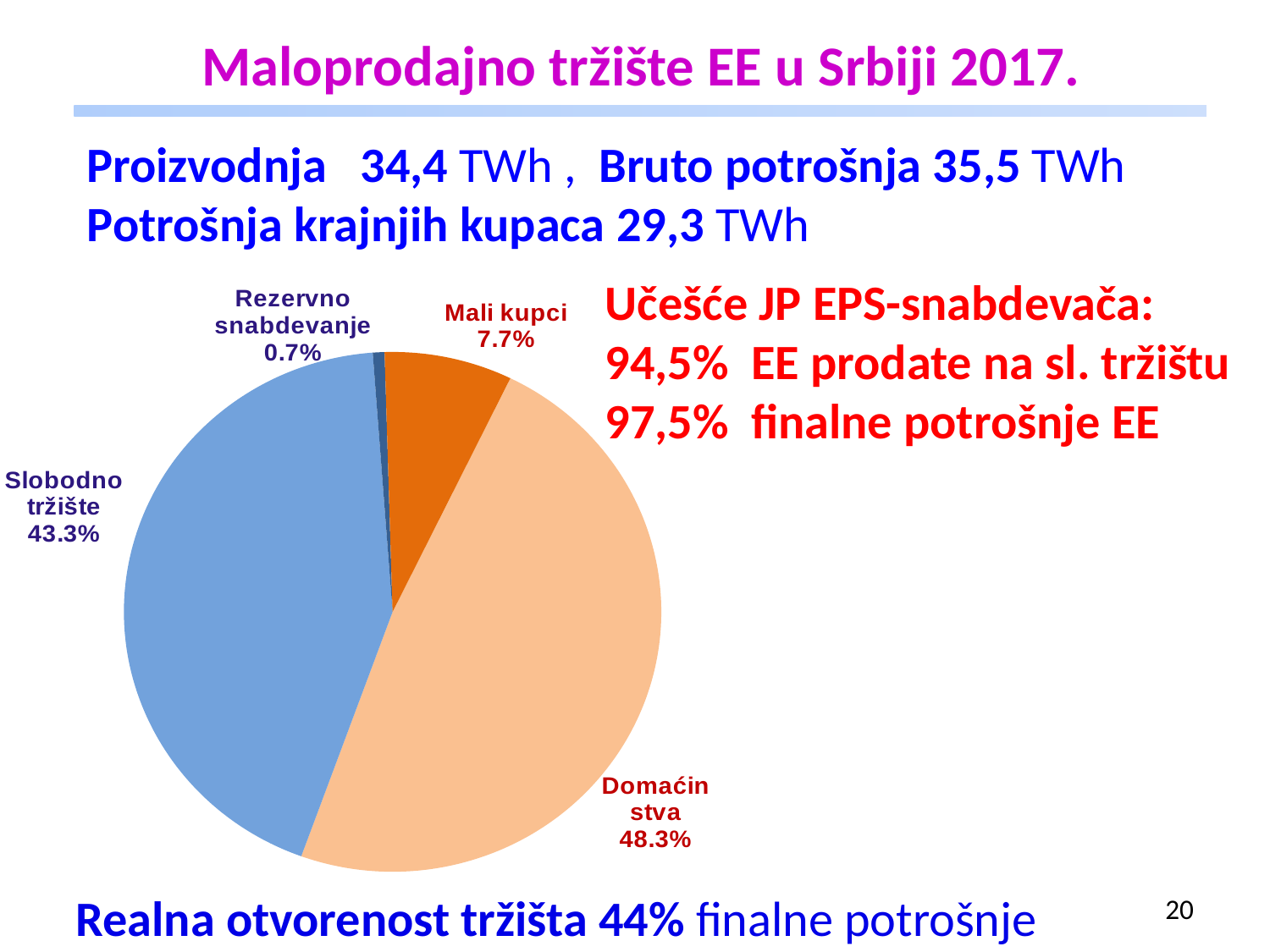
What is the value shown for Rezervno snabdevanje? 0.7% Which slice of the pie chart is the largest? Domaćinstva What share of the pie does Domaćinstva have? 48.3% What type of chart is shown on the slide? pie chart What is the difference between the shares of Mali kupci and Rezervno snabdevanje? 7.0% Which slice of the pie chart is the smallest? Rezervno snabdevanje What is the value shown for Mali kupci? 7.7% How many slices does the pie chart have? 4 What is the title of the slide containing the pie chart? Maloprodajno tržište EE u Srbiji 2017. Which is larger, Mali kupci or Rezervno snabdevanje? Mali kupci What share of the pie does Slobodno tržište have? 43.3% What is the difference between the shares of Domaćinstva and Slobodno tržište? 5.0%